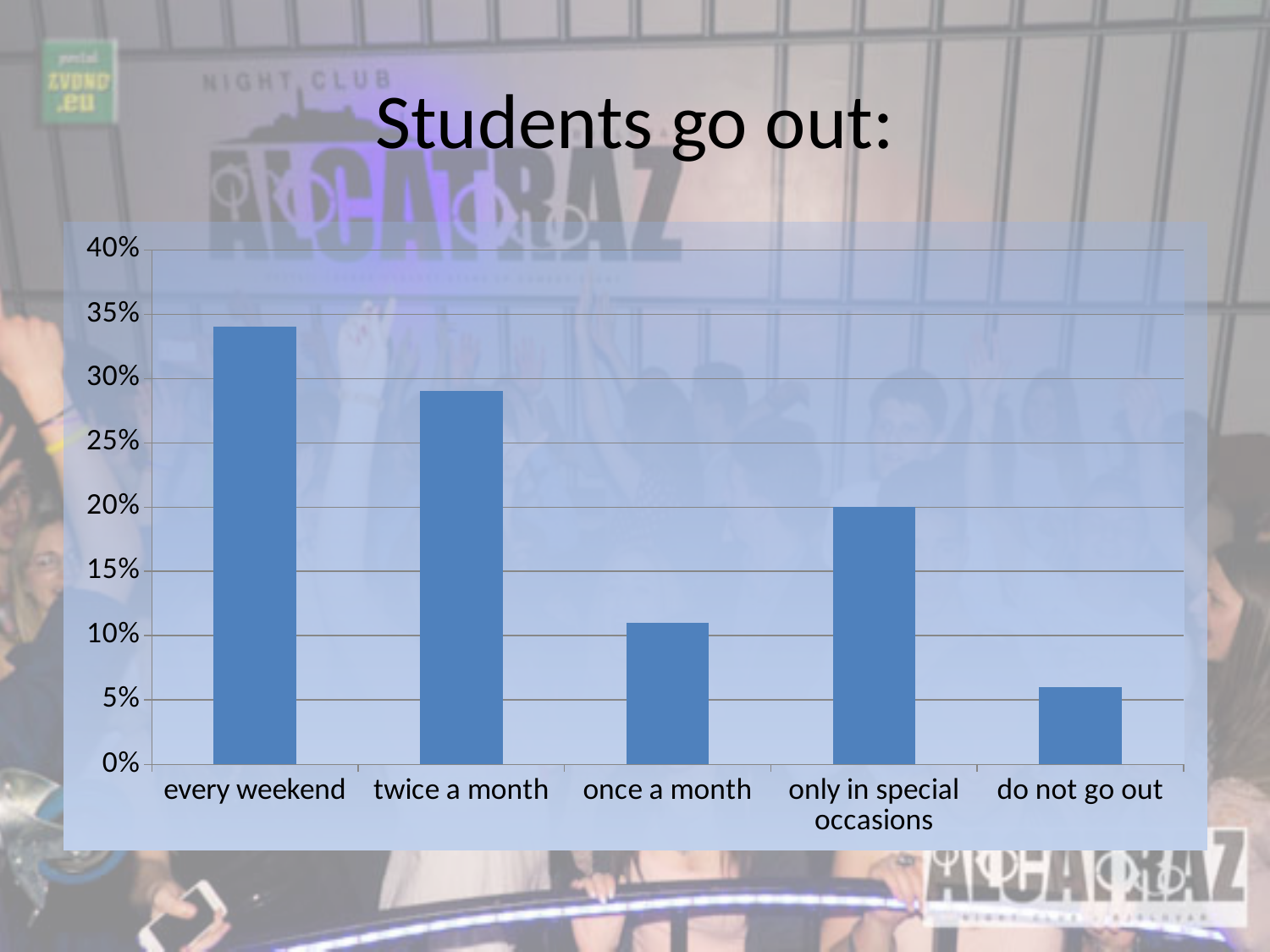
Which is larger, the value for 'twice a month' or the value for 'only in special occasions'? twice a month What is the title of the chart? Students go out: What is the value for 'only in special occasions'? 20% Is the value for 'do not go out' greater or less than 10%? less Which is larger, the value for 'once a month' or the value for 'do not go out'? once a month Which category has the lowest value? do not go out What kind of chart is shown on the slide? bar chart Is the value for 'every weekend' greater or less than 30%? greater Which category has the highest value? every weekend Is the value for 'twice a month' greater or less than 25%? greater How many categories are shown on the x axis of the chart? 5